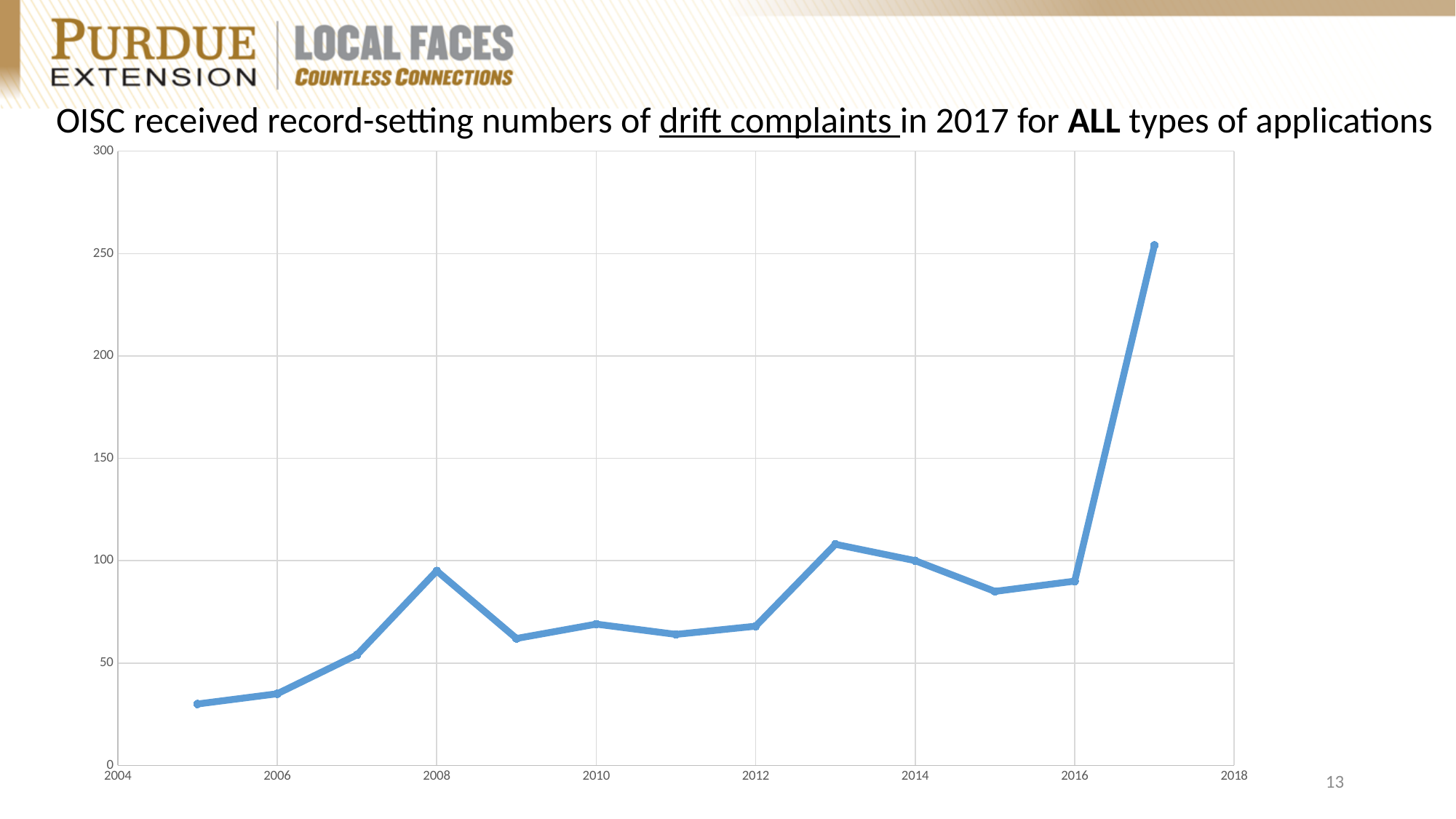
Which year has the larger value, 2013 or 2009? 2013 Is the value for 2008 greater or less than 100? less Which year has the larger value, 2008 or 2017? 2017 Which year has the lowest number of drift complaints? 2005 How many data points are plotted on the line? 13 Is the value for 2013 greater or less than 100? greater Is the value for 2015 greater or less than 100? less Does the line rise or fall between 2016 and 2017? rise What kind of chart is shown on the slide? line chart Which year has the highest number of drift complaints? 2017